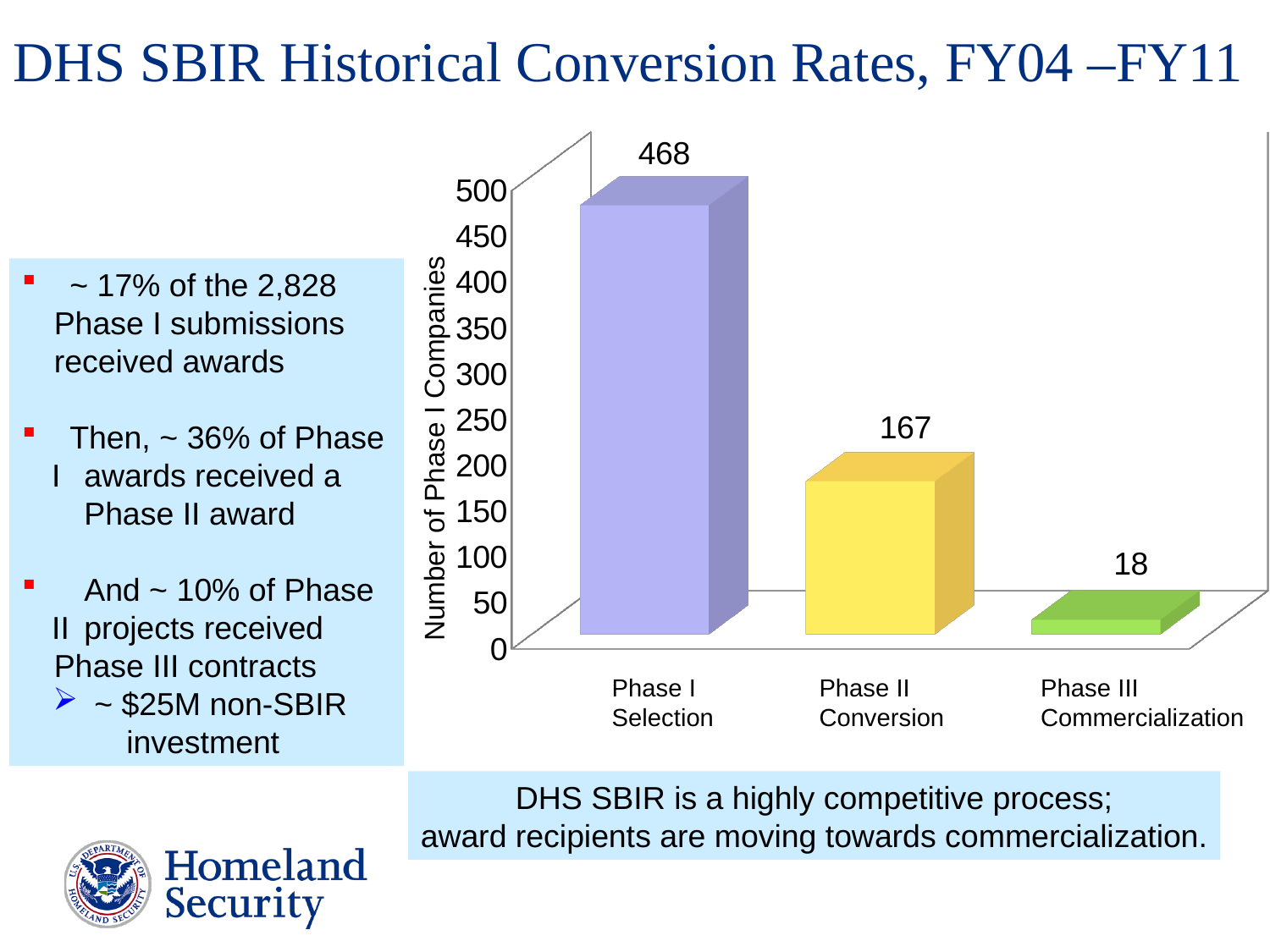
How many categories are shown in the chart? 3 What is the value for Phase I Selection? 468 What is the difference between the values for Phase II Conversion and Phase III Commercialization? 149 Which category has the lowest value? Phase III Commercialization Is the value for Phase II Conversion greater or less than 200? less Which category has the highest value? Phase I Selection What is the value for Phase III Commercialization? 18 What is the difference between the values for Phase I Selection and Phase II Conversion? 301 Which is larger, the value for Phase II Conversion or Phase III Commercialization? Phase II Conversion What is the label of the vertical axis? Number of Phase I Companies What kind of chart is shown on the slide? bar chart What is the value for Phase II Conversion? 167